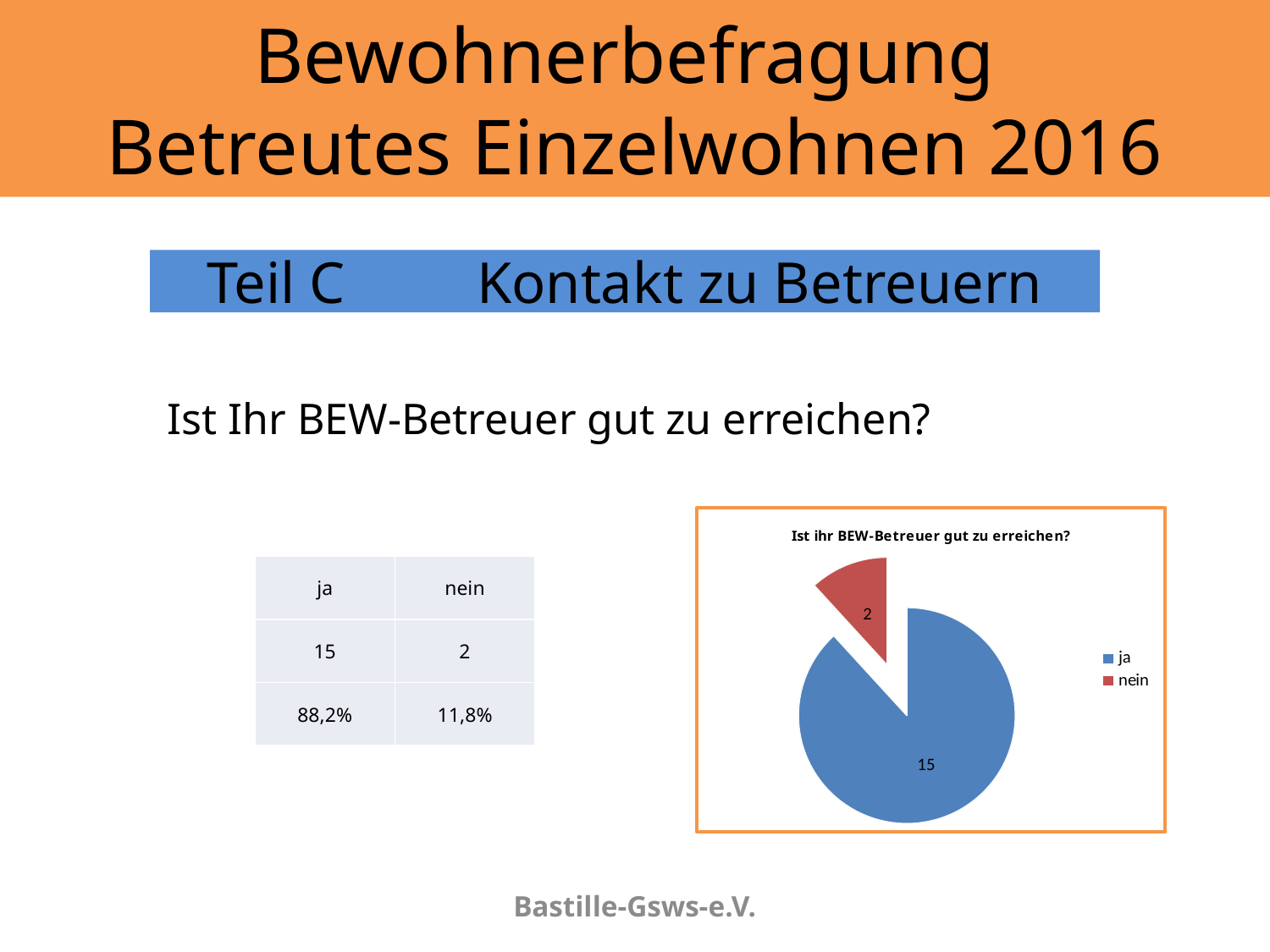
What is the difference between the values for "ja" and "nein" in the pie chart? 13 Which is larger in the pie chart, "ja" or "nein"? ja What kind of chart is shown on the slide? pie chart What colour is the "nein" slice in the pie chart? red Which category has the largest slice in the pie chart? ja What is the value for "nein" in the pie chart? 2 What is the value for "ja" in the pie chart? 15 What is the title of the pie chart? Ist ihr BEW-Betreuer gut zu erreichen? How many entries does the legend of the pie chart list? 2 Which category has the smallest slice in the pie chart? nein What is the total of all slices in the pie chart? 17 How many slices does the pie chart have? 2